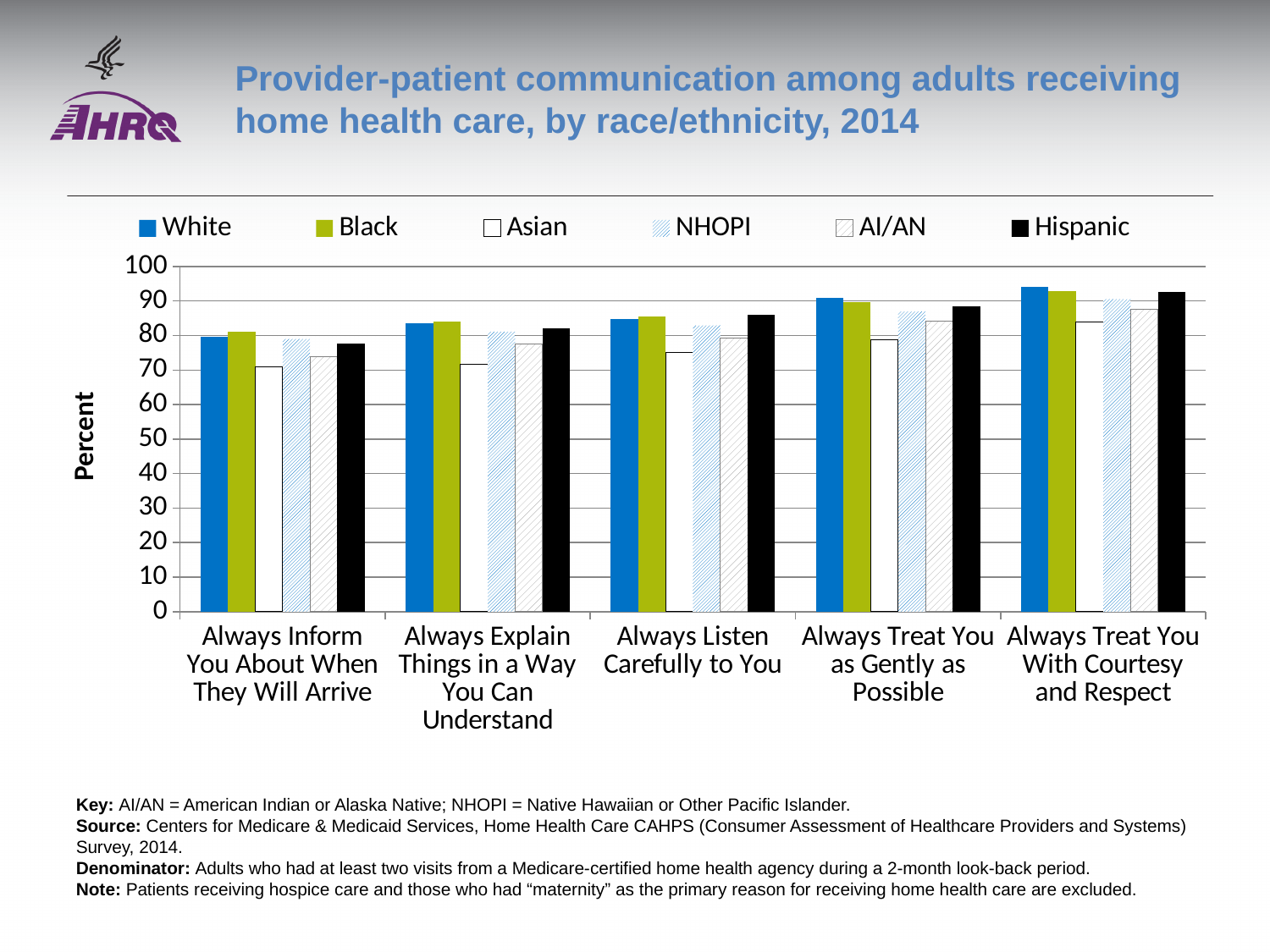
Which race/ethnicity group has the lowest value for "Always Explain Things in a Way You Can Understand"? Asian What kind of chart is shown on the slide? Bar chart For the White group, which measure has the highest value? Always Treat You With Courtesy and Respect How many communication measures (categories) are shown along the x axis? 5 How many series does the legend list? 6 Is the value for Asian under "Always Explain Things in a Way You Can Understand" greater or less than 80? less Is the value for White under "Always Treat You With Courtesy and Respect" greater or less than 90? greater Is the value for Asian under "Always Inform You About When They Will Arrive" greater or less than 80? less Which race/ethnicity group has the lowest value for "Always Treat You as Gently as Possible"? Asian What is the label on the y axis of the chart? Percent For "Always Listen Carefully to You", which is larger: the value for White or the value for Asian? White For "Always Treat You With Courtesy and Respect", which is larger: the value for Hispanic or the value for AI/AN? Hispanic